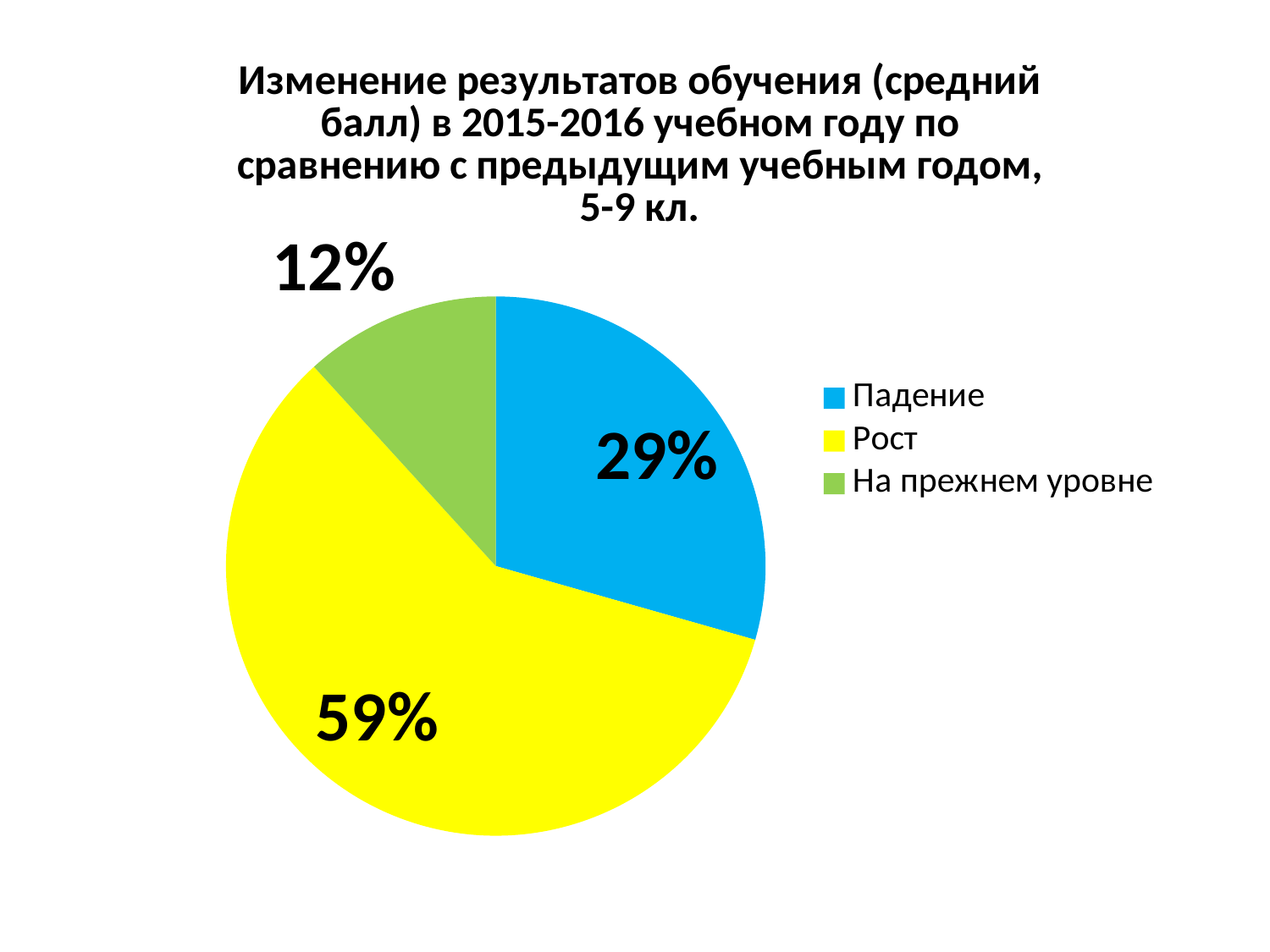
Which category has the smallest slice? На прежнем уровне What colour is the slice for Рост? Yellow Which category is shown in blue in the legend? Падение Which is larger, Падение or На прежнем уровне? Падение Which category has the largest slice? Рост What is the difference in percentage points between Рост and Падение? 30 What kind of chart is shown on the slide? Pie chart What share of the pie does Рост take? 59% What share of the pie does Падение take? 29% What share of the pie does На прежнем уровне take? 12% What is the difference in percentage points between Падение and На прежнем уровне? 17 How many categories does the pie chart show? 3